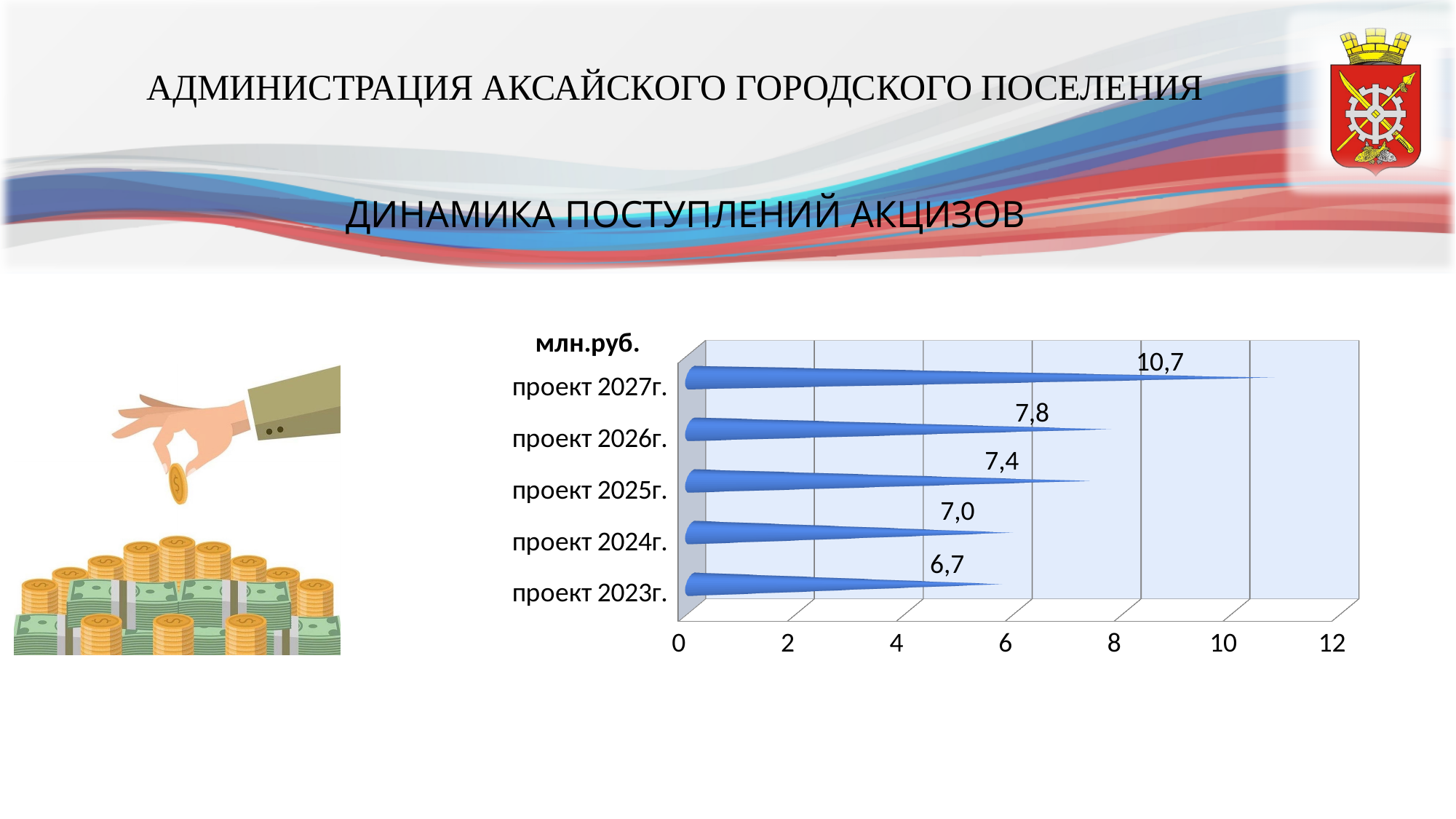
What is the value for проект 2027г.? 10,7 What unit is indicated above the chart? млн.руб. Is the value for проект 2027г. greater or less than 10? greater How many categories are shown in the chart? 5 What is the value for проект 2023г.? 6,7 Which category has the highest value? проект 2027г. Which category has the lowest value? проект 2023г. What kind of chart is shown on the slide? bar chart What is the value for проект 2025г.? 7,4 Which is larger, the value for проект 2026г. or проект 2025г.? проект 2026г. What is the difference between the values for проект 2024г. and проект 2023г.? 0,3 What is the difference between the values for проект 2027г. and проект 2026г.? 2,9